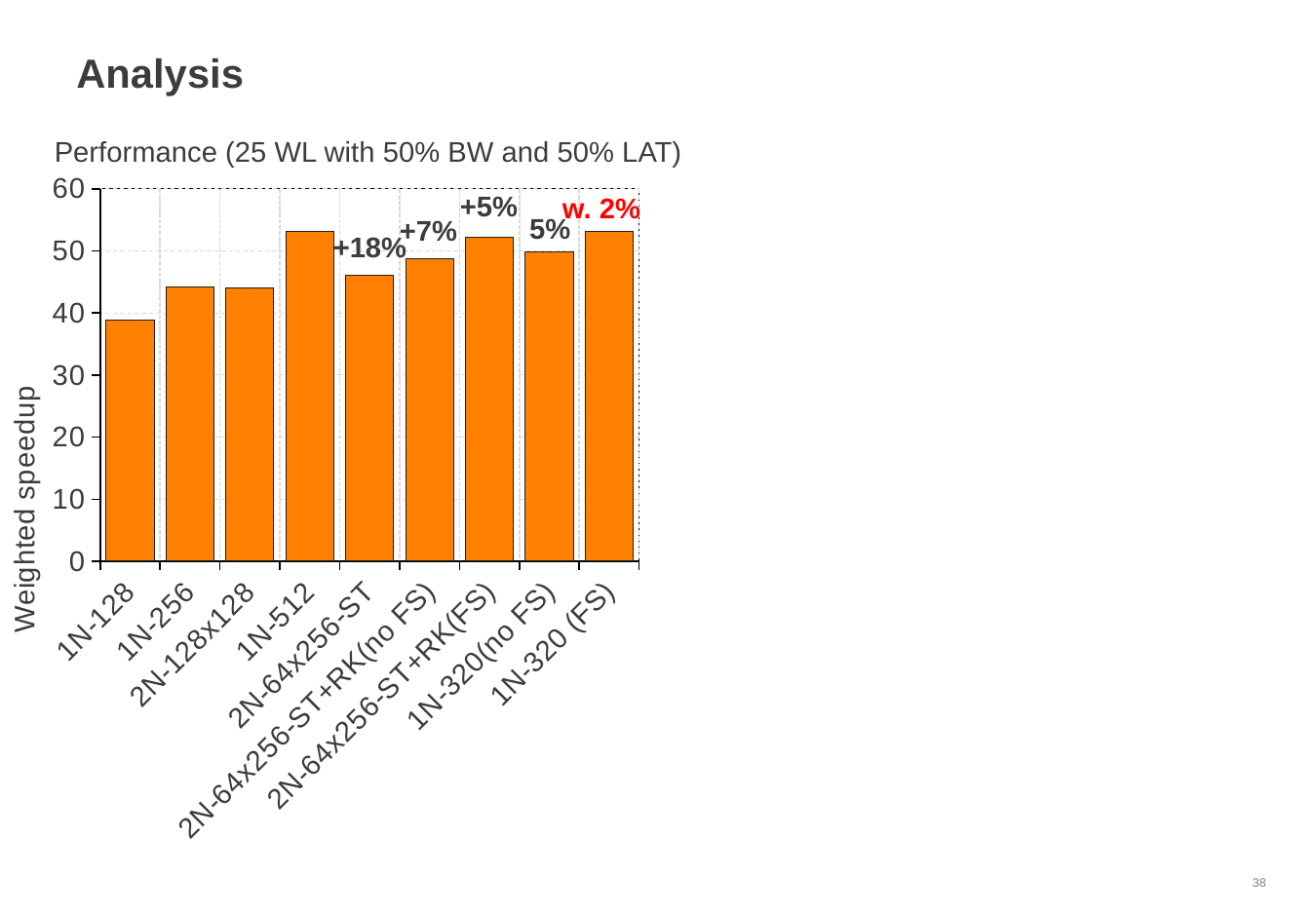
What kind of chart is shown on the slide? bar chart Is the value for 1N-256 greater or less than 40? greater Which has the larger weighted speedup, 1N-512 or 1N-128? 1N-512 Which has the larger weighted speedup, 2N-64x256-ST+RK(FS) or 2N-64x256-ST? 2N-64x256-ST+RK(FS) Is the value for 2N-64x256-ST+RK(FS) greater or less than 50? greater How many categories are plotted on the x axis of the chart? 9 What annotation is printed in red above the 1N-320 (FS) bar? w. 2% Is the value for 1N-512 greater or less than 50? greater What is the title of the chart? Performance (25 WL with 50% BW and 50% LAT) Which category has the lowest weighted speedup? 1N-128